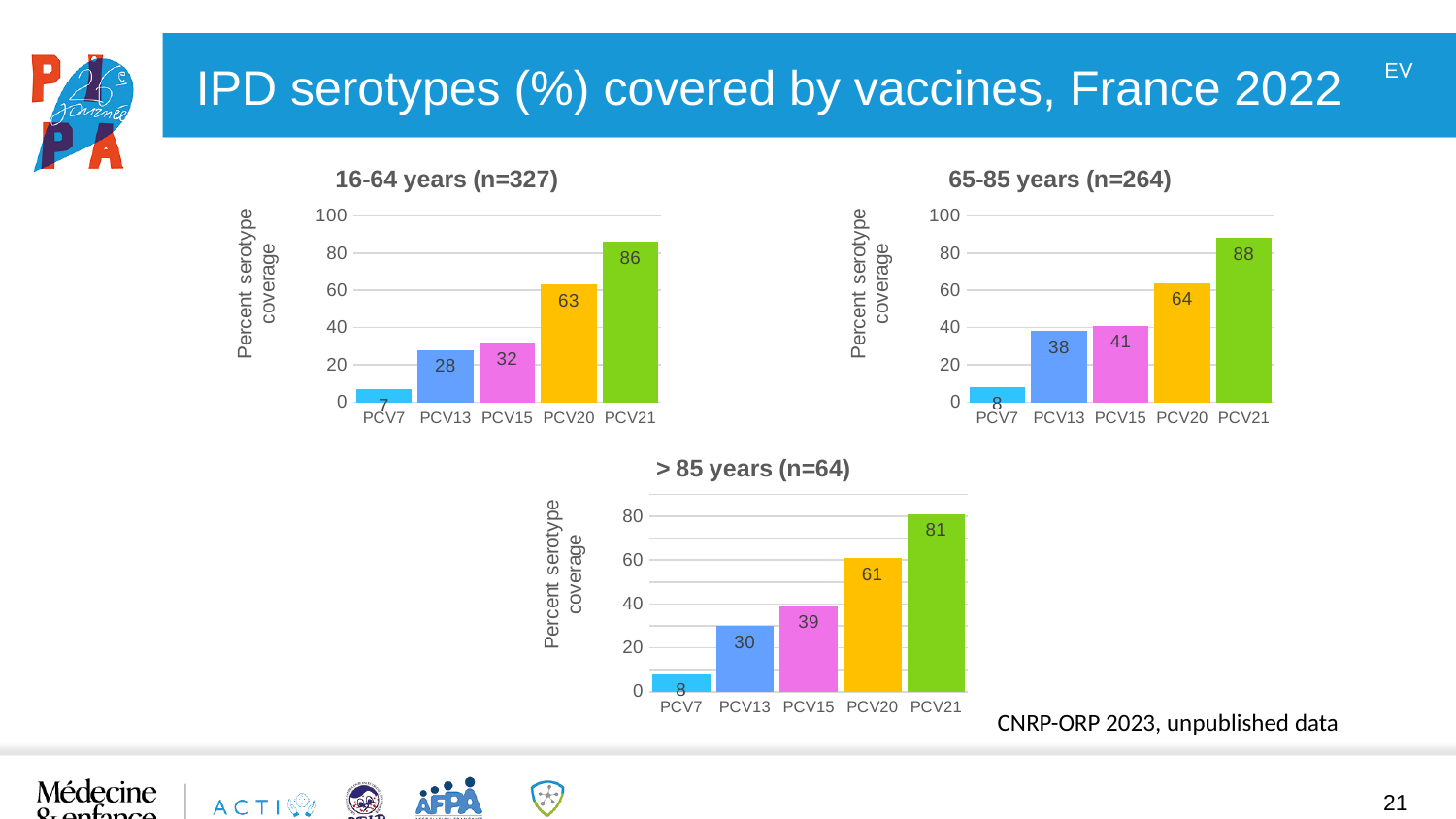
How many vaccines are shown on the x axis of the '> 85 years (n=64)' chart? 5 In the '> 85 years (n=64)' chart, what is the difference in percent serotype coverage between PCV21 and PCV20? 20 What is the label of the y axis on the '> 85 years (n=64)' chart? Percent serotype coverage In the '16-64 years (n=327)' chart, do the values rise or fall from PCV7 to PCV21? Rise In the '65-85 years (n=264)' chart, what is the percent serotype coverage for PCV15? 41 In the '16-64 years (n=327)' chart, which vaccine has the highest percent serotype coverage? PCV21 In the '65-85 years (n=264)' chart, which vaccine has the lowest percent serotype coverage? PCV7 In the '> 85 years (n=64)' chart, what is the percent serotype coverage for PCV13? 30 What type of chart is the '65-85 years (n=264)' chart? Bar chart In the '16-64 years (n=327)' chart, what is the percent serotype coverage for PCV20? 63 In the '65-85 years (n=264)' chart, which has a higher percent serotype coverage, PCV13 or PCV20? PCV20 In the '16-64 years (n=327)' chart, what is the difference in percent serotype coverage between PCV15 and PCV13? 4